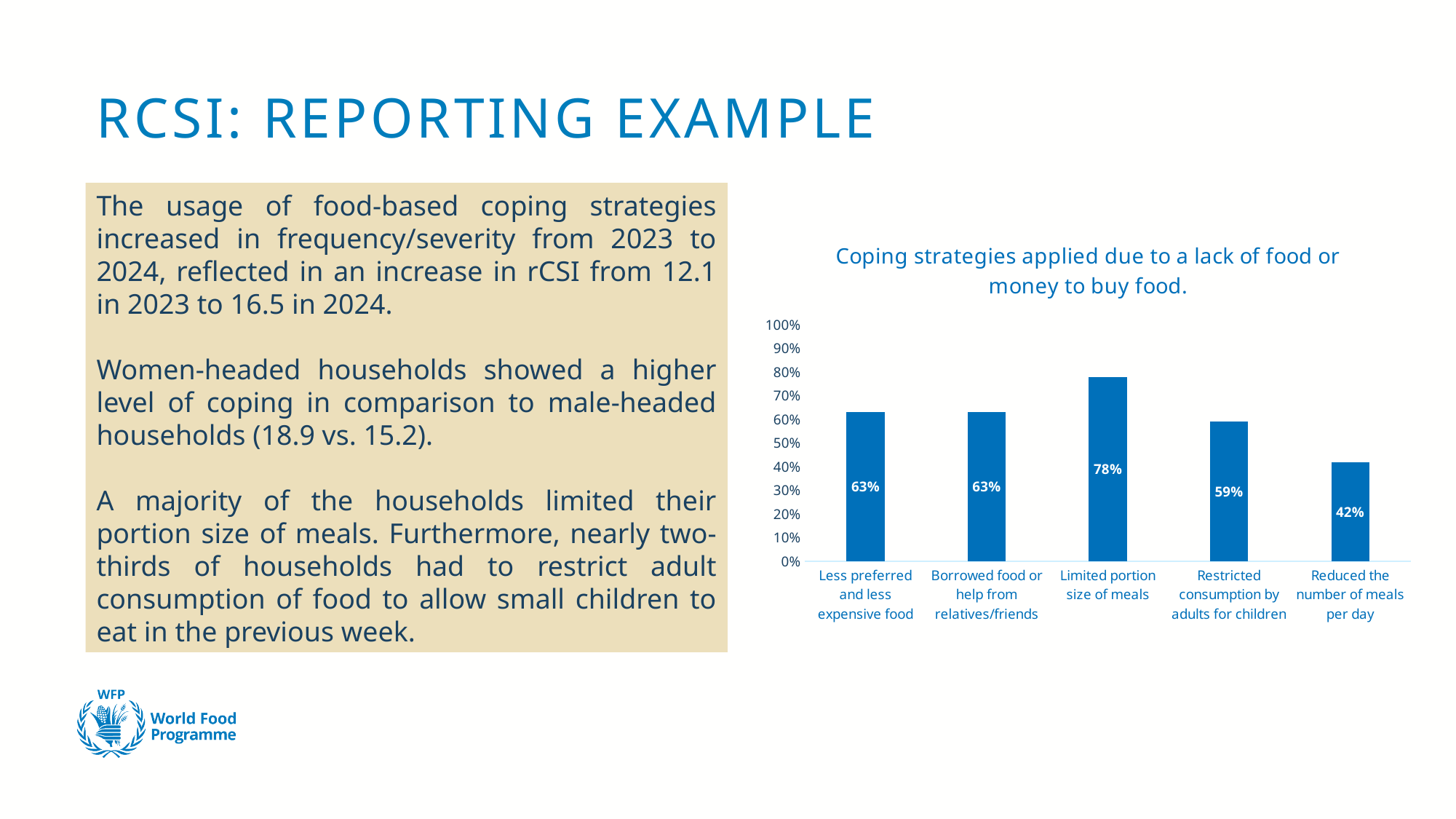
What is the difference between the values for 'Limited portion size of meals' and 'Reduced the number of meals per day'? 36% What type of chart is shown on the slide? Bar chart How many coping strategies are shown in the chart? 5 What is the value for 'Reduced the number of meals per day'? 42% Which coping strategy has the lowest value? Reduced the number of meals per day Which is larger: the value for 'Borrowed food or help from relatives/friends' or 'Restricted consumption by adults for children'? Borrowed food or help from relatives/friends What is the value for 'Restricted consumption by adults for children'? 59% Is the value for 'Reduced the number of meals per day' greater or less than 50%? less What percentage of households limited portion size of meals? 78% What is the difference between 'Less preferred and less expensive food' and 'Restricted consumption by adults for children'? 4% Which coping strategy has the highest value? Limited portion size of meals What is the title of the chart? Coping strategies applied due to a lack of food or money to buy food.